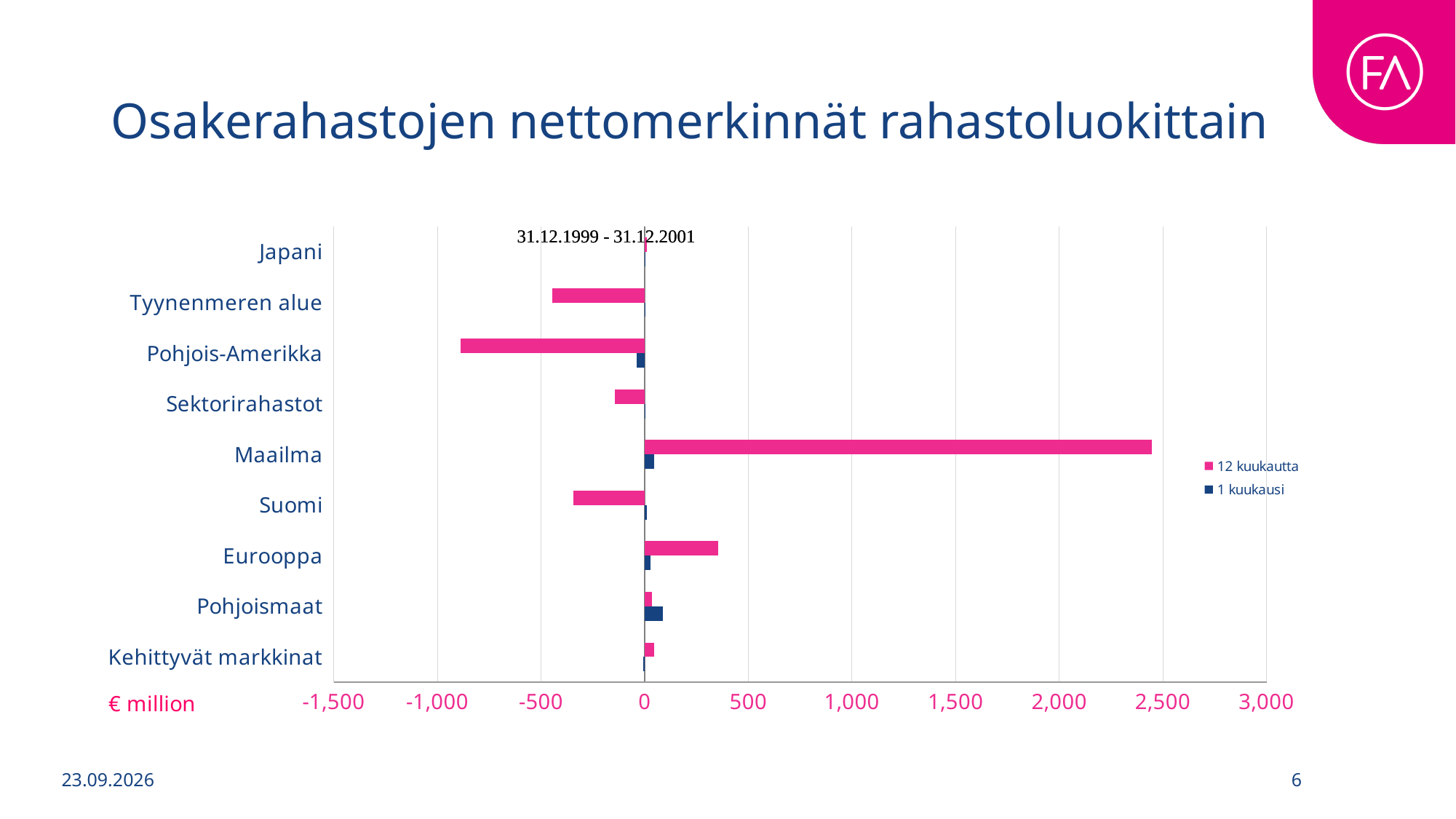
Is the 12 kuukautta value for Maailma greater or less than 2,000? greater Which series is shown in pink in the chart legend? 12 kuukautta Is the 12 kuukautta value for Tyynenmeren alue greater or less than 0? less Which category has the lowest (most negative) value for the 12 kuukautta series? Pohjois-Amerikka How many fund categories are listed on the vertical axis of the chart? 9 Is the 12 kuukautta value for Pohjois-Amerikka greater or less than -500? less Which category has the highest value for the 12 kuukautta series? Maailma For the 12 kuukautta series, which is larger: Maailma or Eurooppa? Maailma How many series does the chart legend list? 2 What unit is shown for the horizontal axis of the chart? € million What kind of chart is shown on the slide? bar chart